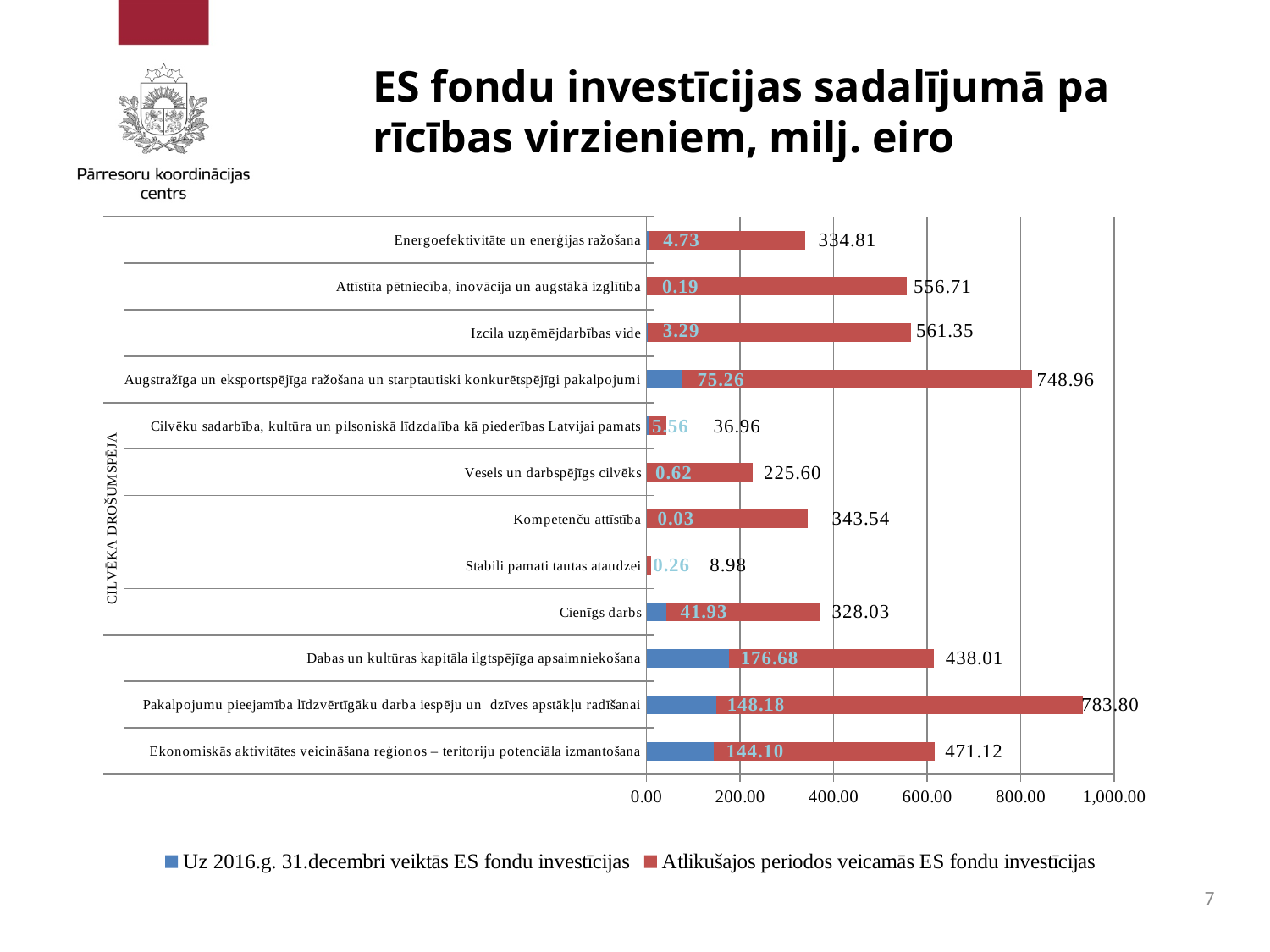
Which category has the highest value for 'Atlikušajos periodos veicamās ES fondu investīcijas'? Pakalpojumu pieejamība līdzvērtīgāku darba iespēju un dzīves apstākļu radīšanai What unit is stated in the chart title for the investment values? milj. eiro What type of chart is shown on the slide? bar chart Which is larger: the 'Atlikušajos periodos veicamās ES fondu investīcijas' value for 'Kompetenču attīstība' or for 'Cienīgs darbs'? Kompetenču attīstība How many categories (rīcības virzieni) are plotted on the chart? 12 What is the difference between the 'Atlikušajos periodos veicamās ES fondu investīcijas' values for 'Augstražīga un eksportspējīga ražošana un starptautiski konkurētspējīgi pakalpojumi' and 'Energoefektivitāte un enerģijas ražošana'? 414.15 Which category has the lowest value for 'Uz 2016.g. 31.decembri veiktās ES fondu investīcijas'? Kompetenču attīstība What is the value of 'Atlikušajos periodos veicamās ES fondu investīcijas' for 'Izcila uzņēmējdarbības vide'? 561.35 What is the value of 'Uz 2016.g. 31.decembri veiktās ES fondu investīcijas' for 'Dabas un kultūras kapitāla ilgtspējīga apsaimniekošana'? 176.68 How many series does the legend list? 2 What is the total of the stacked bar for 'Ekonomiskās aktivitātes veicināšana reģionos – teritoriju potenciāla izmantošana'? 615.22 Which category has the lowest value for 'Atlikušajos periodos veicamās ES fondu investīcijas'? Stabili pamati tautas ataudzei